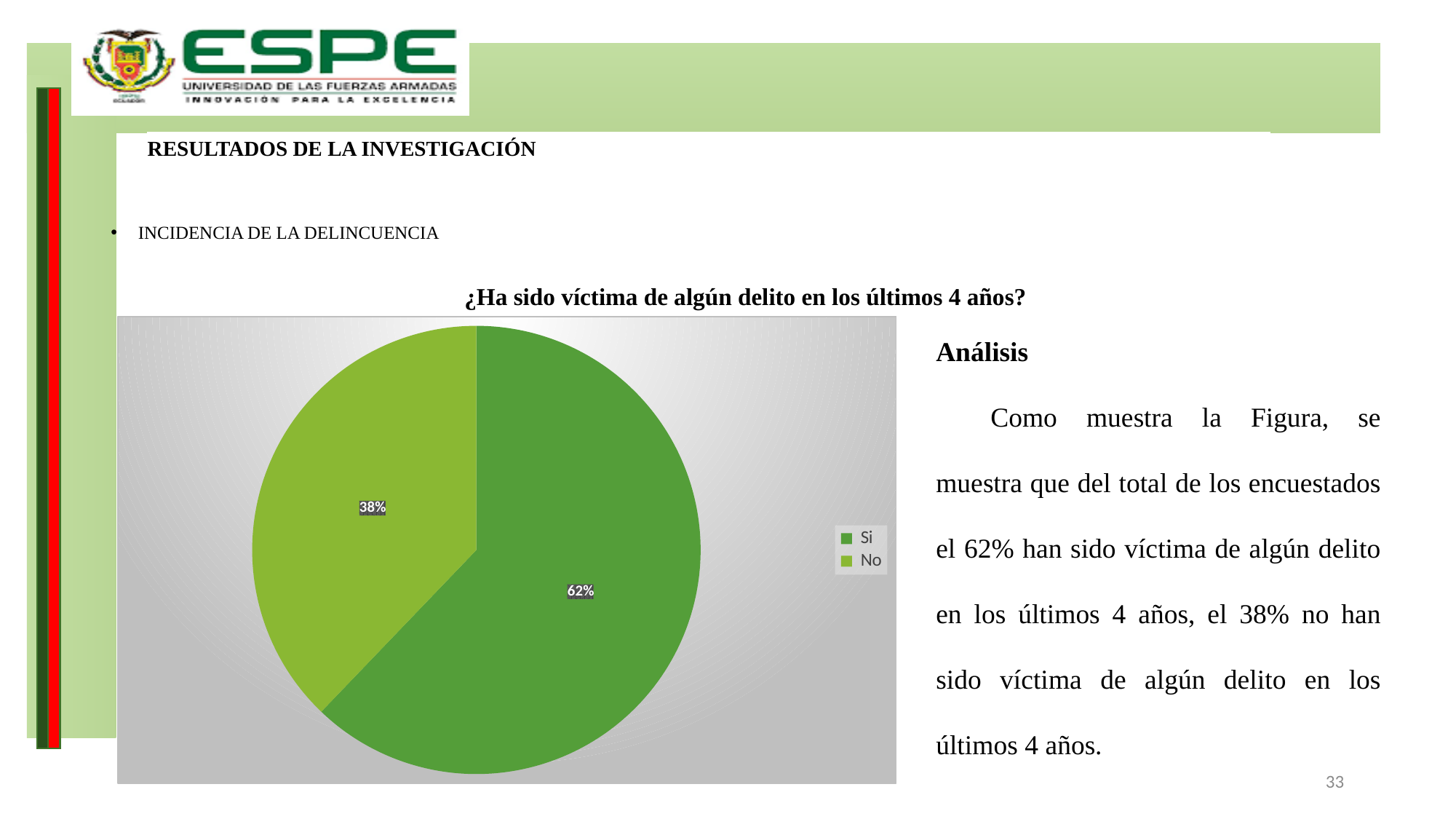
Which slice of the pie chart is the largest? Si Which slice of the pie chart is the smallest? No How many entries does the legend of the pie chart list? 2 How many slices does the pie chart have? 2 Which legend entry is shown in the lighter green colour? No What is the title of the pie chart? ¿Ha sido víctima de algún delito en los últimos 4 años? Which is larger in the pie chart, "Si" or "No"? Si What is the difference in percentage points between the "Si" and "No" slices? 24 What percentage of the pie chart corresponds to "No"? 38% What kind of chart is shown on the slide? pie chart What share of the pie does the "No" slice represent? 38% What percentage of the pie chart corresponds to "Si"? 62%